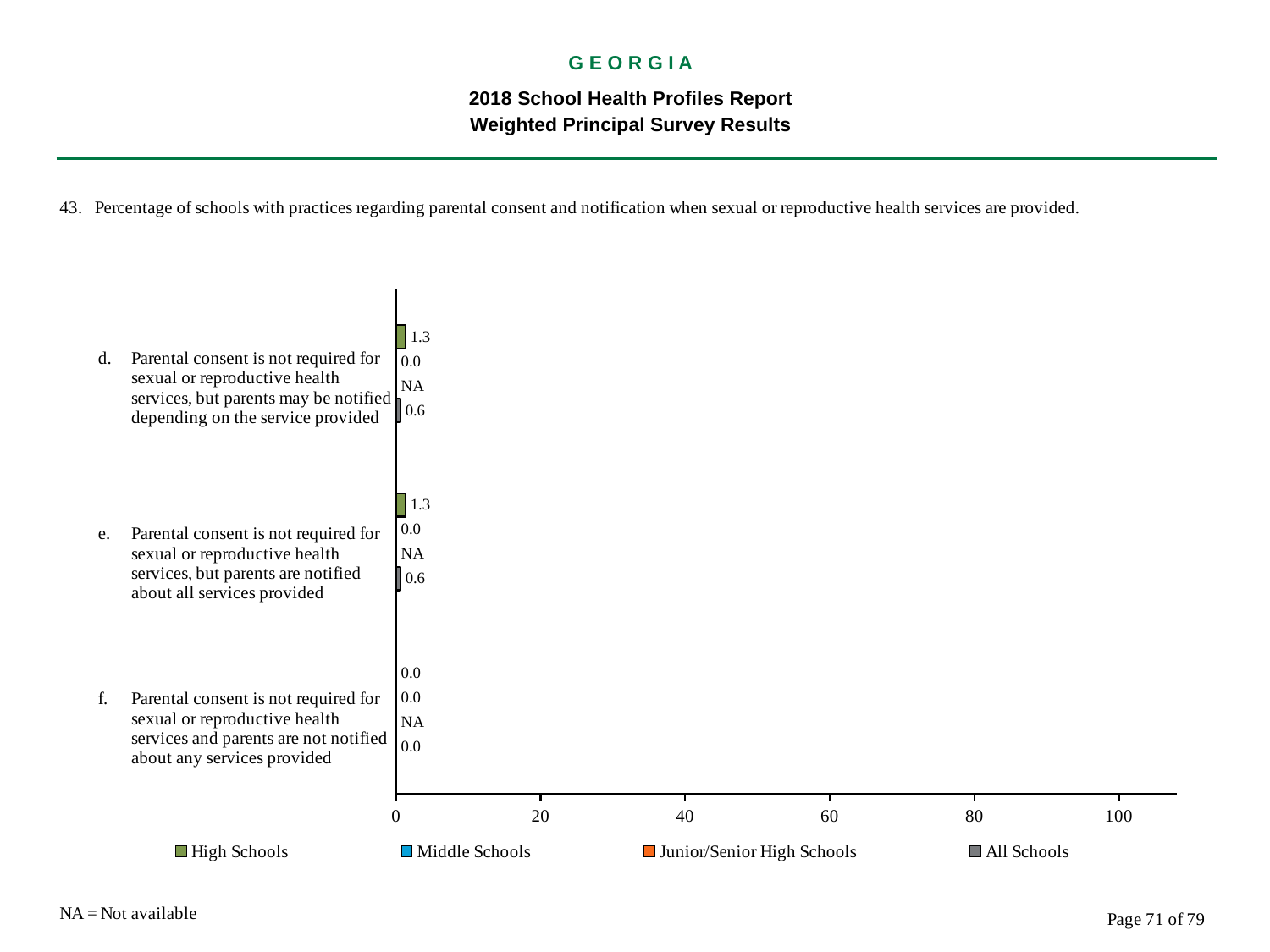
What is the High Schools value for practice f (parental consent not required and parents are not notified about any services provided)? 0.0 What does NA stand for according to the note on the slide? Not available What is the difference between the High Schools value and the All Schools value for practice d? 0.7 For practice e, which is larger: the High Schools value or the All Schools value? High Schools What is the High Schools value for practice d (parental consent not required, but parents may be notified depending on the service provided)? 1.3 What is the Middle Schools value for practice d? 0.0 How many categories (practices) are plotted on the chart? 3 How many series does the legend list? 4 What is shown for Junior/Senior High Schools for practice f? NA What is the All Schools value for practice e (parental consent not required, but parents are notified about all services provided)? 0.6 What kind of chart is shown on the slide? bar chart Is the High Schools value for practice d greater or less than 20? less